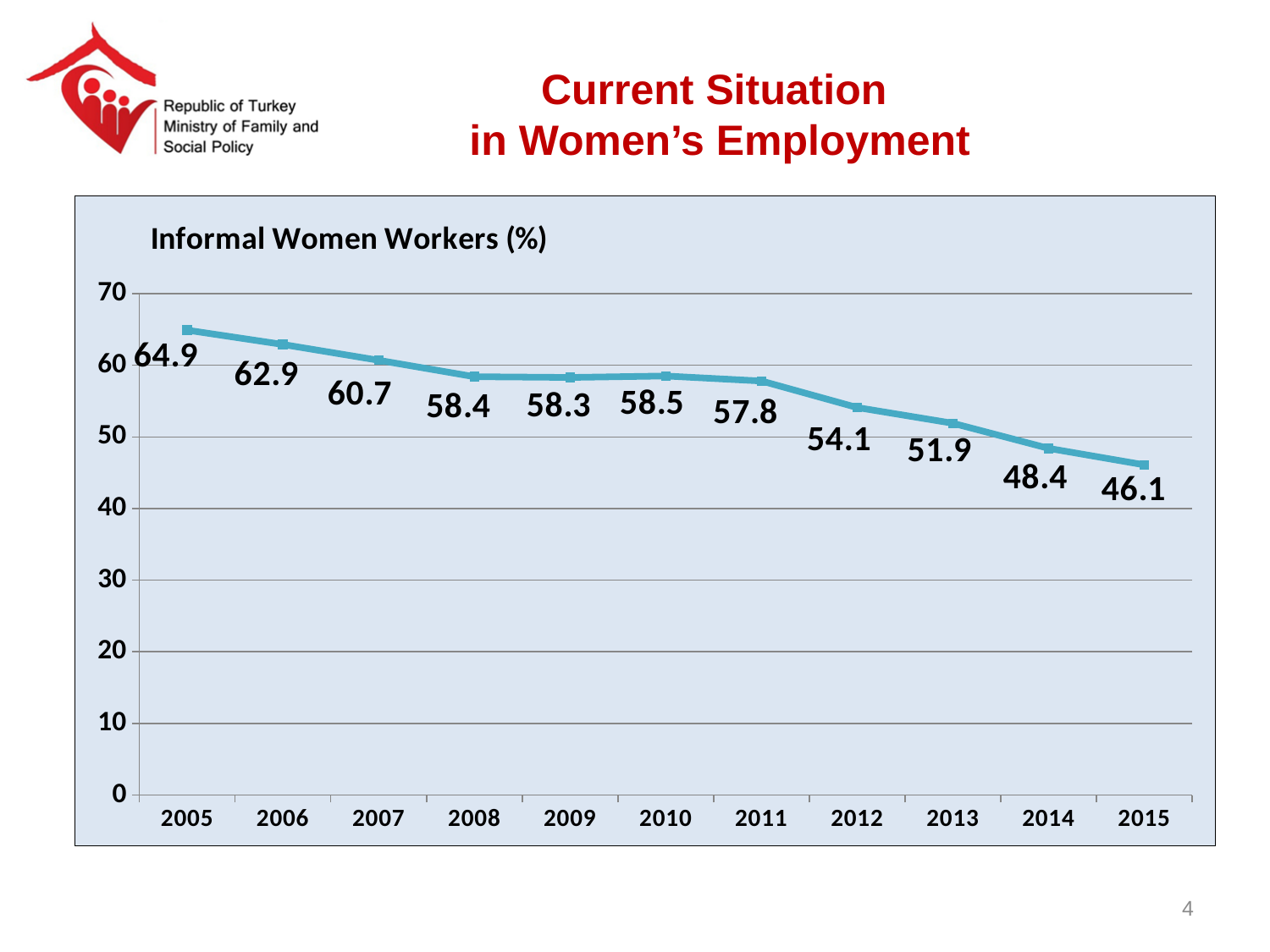
What is the value for 2012? 54.1 How many years are plotted on the chart? 11 What is the title of the chart? Informal Women Workers (%) What is the value for 2005? 64.9 Which is larger, the value for 2007 or the value for 2013? 2007 What kind of chart is shown? line chart Is the value for 2014 greater or less than 50? less Which year has the highest value? 2005 What is the value for 2015? 46.1 Which year has the lowest value? 2015 What is the difference between the values for 2005 and 2015? 18.8 Do the values generally rise or fall from 2005 to 2015? fall